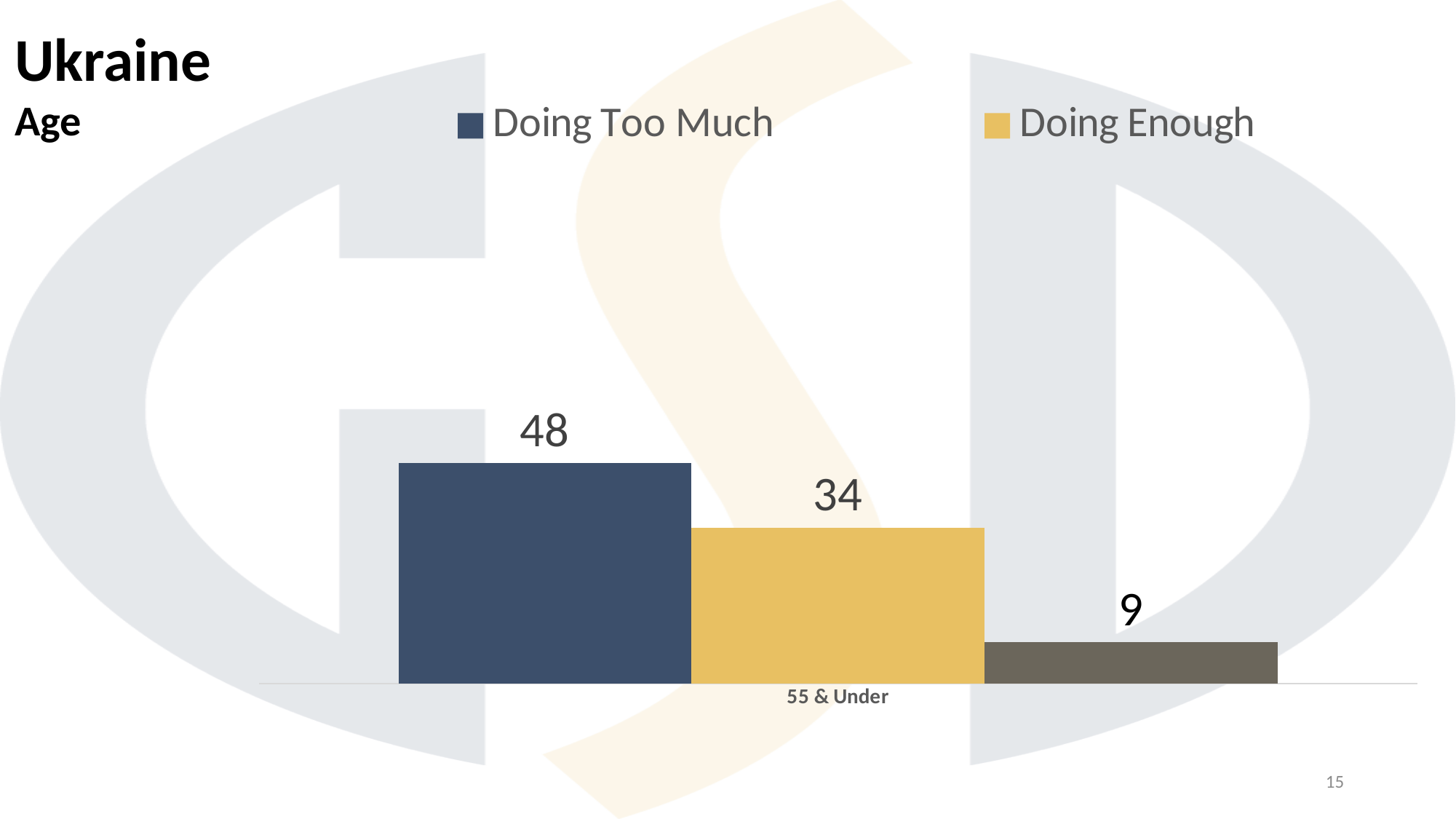
Which series has the highest value for 55 & Under, Doing Too Much or Doing Enough? Doing Too Much How many series does the legend list? 2 What kind of chart is shown on the slide? bar chart Is the value for Doing Too Much larger or smaller than the value for Doing Enough? larger What is the value shown on the gray bar at the right of the chart? 9 What is the category label shown on the x axis? 55 & Under How many categories are shown on the x axis? 1 What colour is the Doing Enough series in the legend? yellow What is the value for Doing Too Much for 55 & Under? 48 What is the difference between the Doing Too Much value and the Doing Enough value for 55 & Under? 14 Which bar is the lowest in the chart: the dark blue, the yellow, or the gray bar? the gray bar What is the value for Doing Enough for 55 & Under? 34